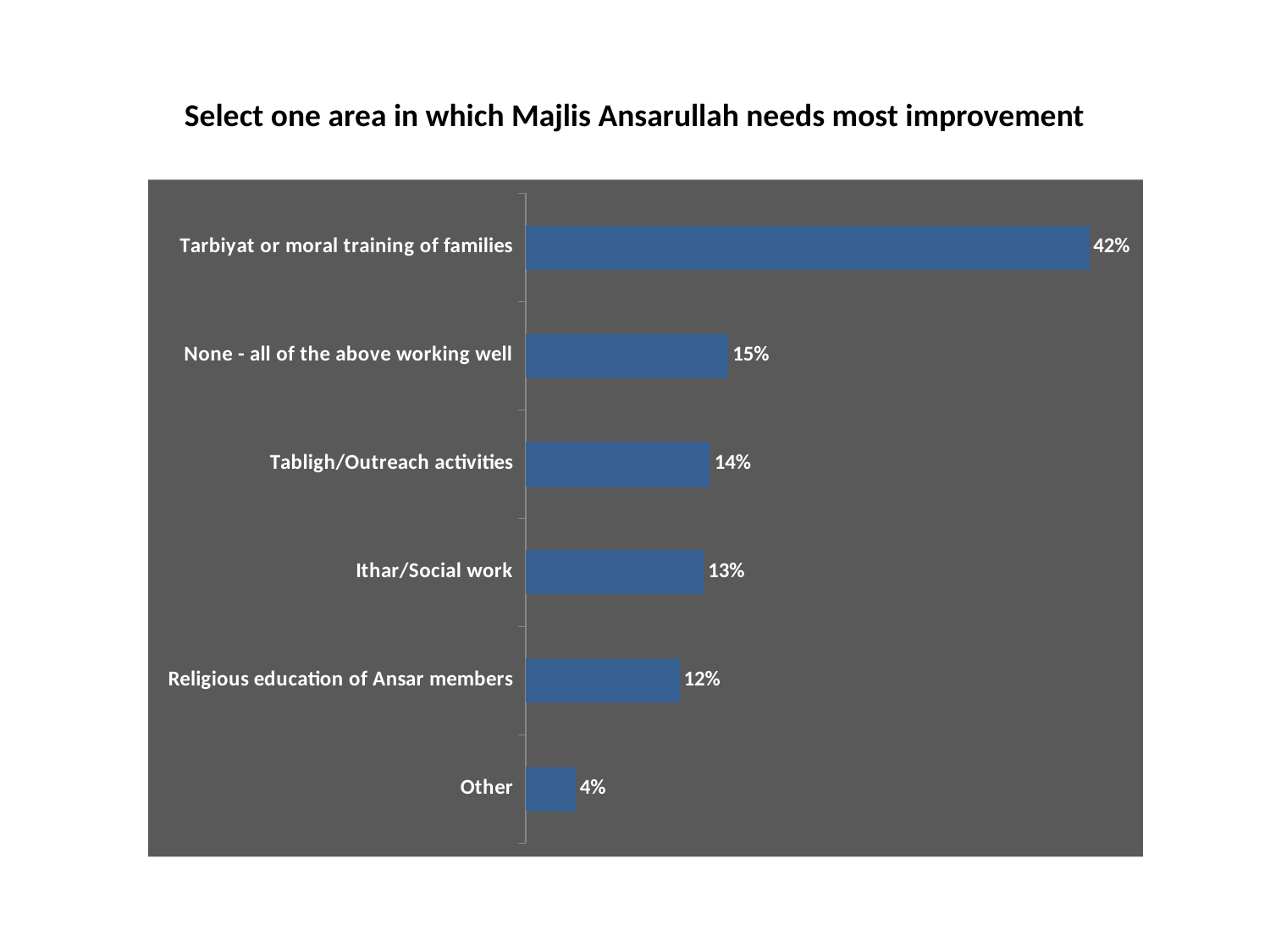
What is the title of the chart? Select one area in which Majlis Ansarullah needs most improvement What is the difference between Tarbiyat or moral training of families and None - all of the above working well? 27% Which category has the lowest value? Other What is the difference between Ithar/Social work and Other? 9% How many categories are shown in the chart? 6 What percentage selected Tarbiyat or moral training of families? 42% Which is larger, None - all of the above working well or Religious education of Ansar members? None - all of the above working well What is the value for Religious education of Ansar members? 12% What kind of chart is shown on the slide? Bar chart What is the value for Tabligh/Outreach activities? 14% What percentage is shown for Other? 4% Which category has the highest value? Tarbiyat or moral training of families